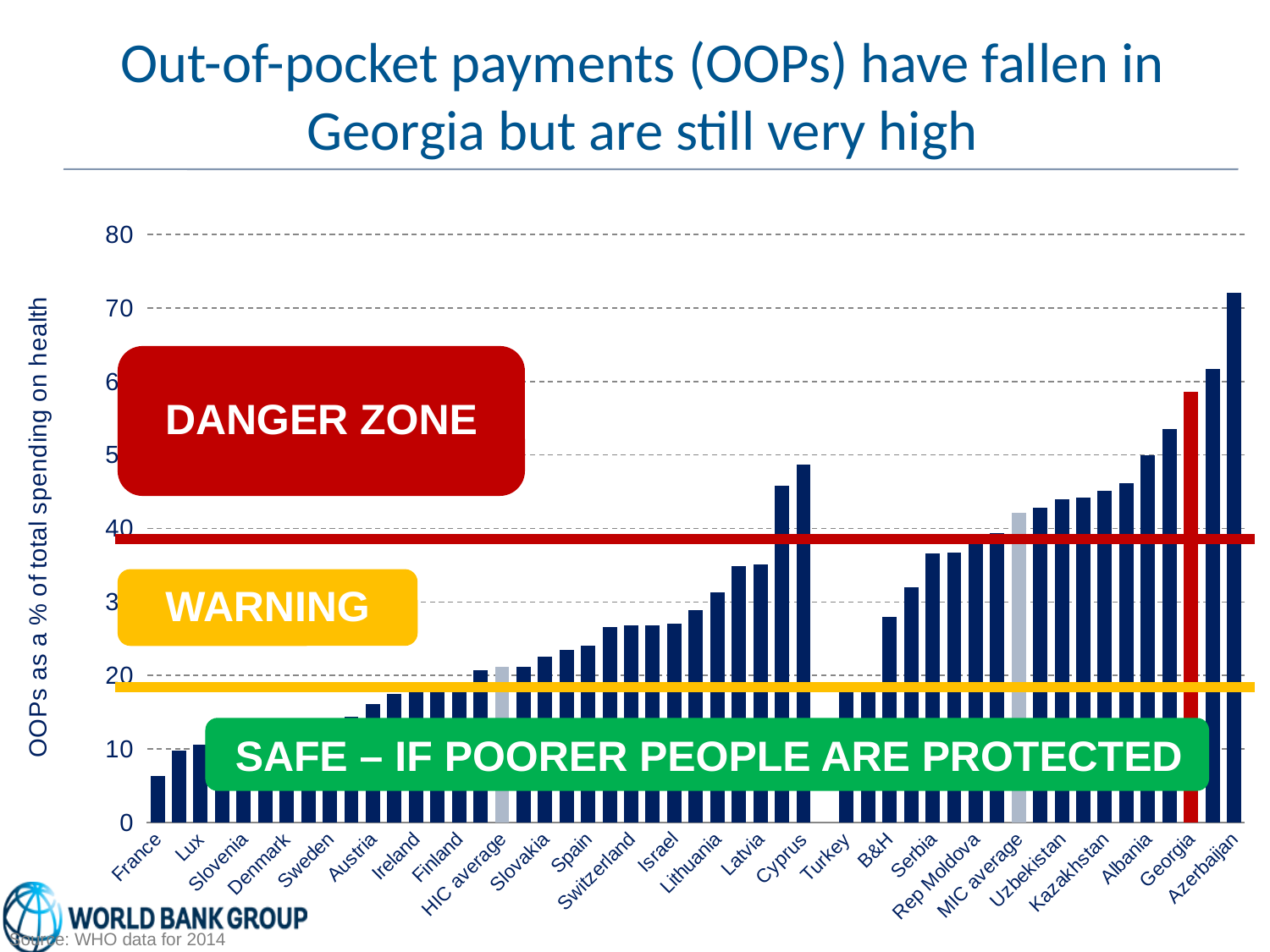
Is the value for Cyprus greater or less than 40? greater What is the label on the vertical axis of the chart? OOPs as a % of total spending on health Is the value for Turkey greater or less than 20? less What kind of chart is shown on the slide? bar chart Is the value for France greater or less than 10? less Do the bar values generally rise or fall from left to right along the x axis? rise Which has a higher value, Georgia or Azerbaijan? Azerbaijan Which country has the lowest out-of-pocket payment share in the chart? France Which country has the highest out-of-pocket payment share in the chart? Azerbaijan